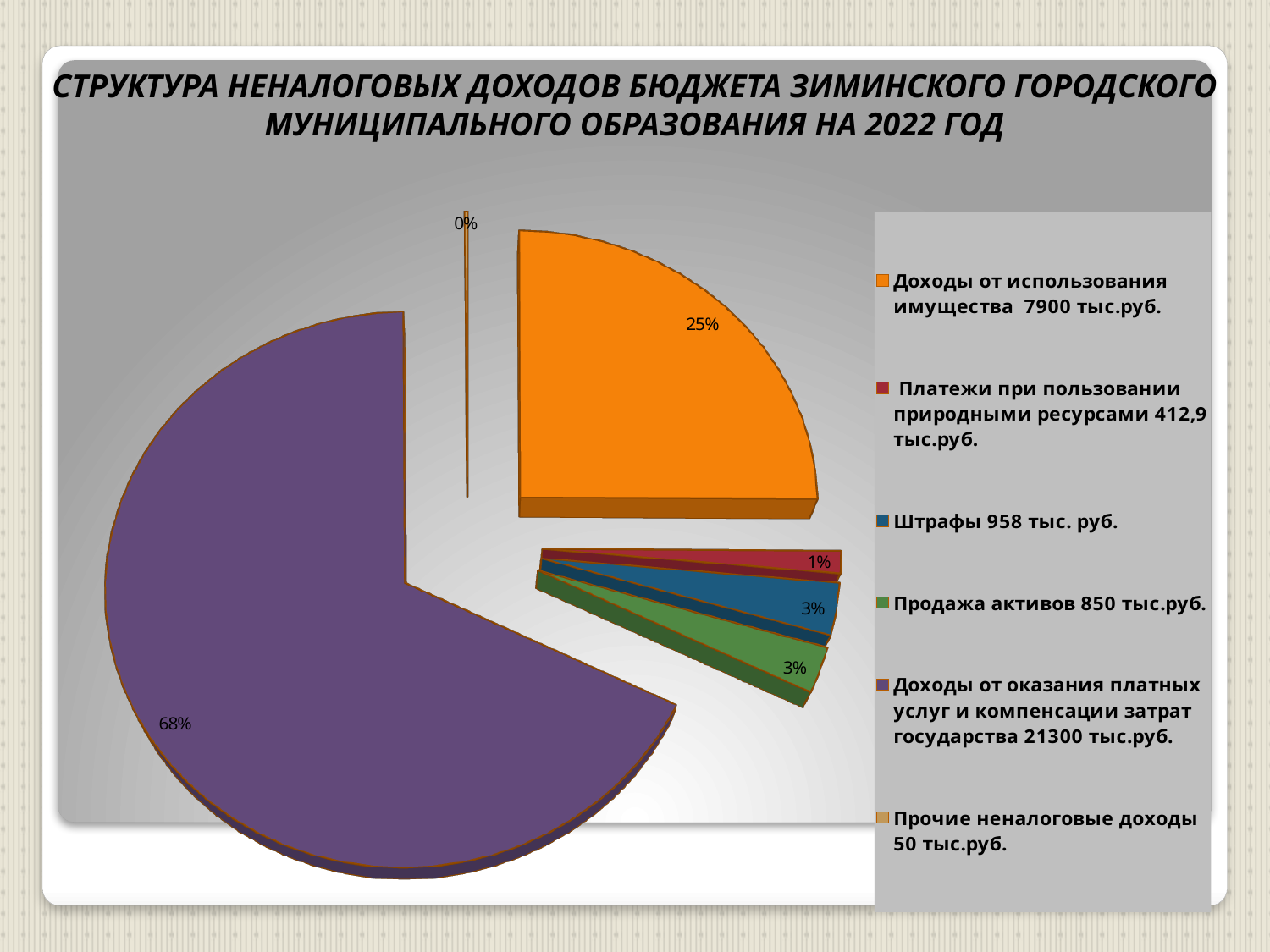
How many entries does the legend list? 6 Which category has the largest slice of the pie? Доходы от оказания платных услуг и компенсации затрат государства What kind of chart is shown on the slide? pie chart What share of the pie is labelled for "Прочие неналоговые доходы"? 0% What share of the pie is labelled for "Платежи при пользовании природными ресурсами"? 1% How many slices does the pie chart have? 6 What is the difference in percentage points between the 68% slice and the 25% slice? 43% Which category has the smallest slice of the pie? Прочие неналоговые доходы What amount in тыс.руб. does the legend give for "Штрафы"? 958 тыс. руб. Which slice is larger: "Доходы от использования имущества" or "Штрафы"? Доходы от использования имущества What share of the pie is labelled for "Доходы от использования имущества"? 25%